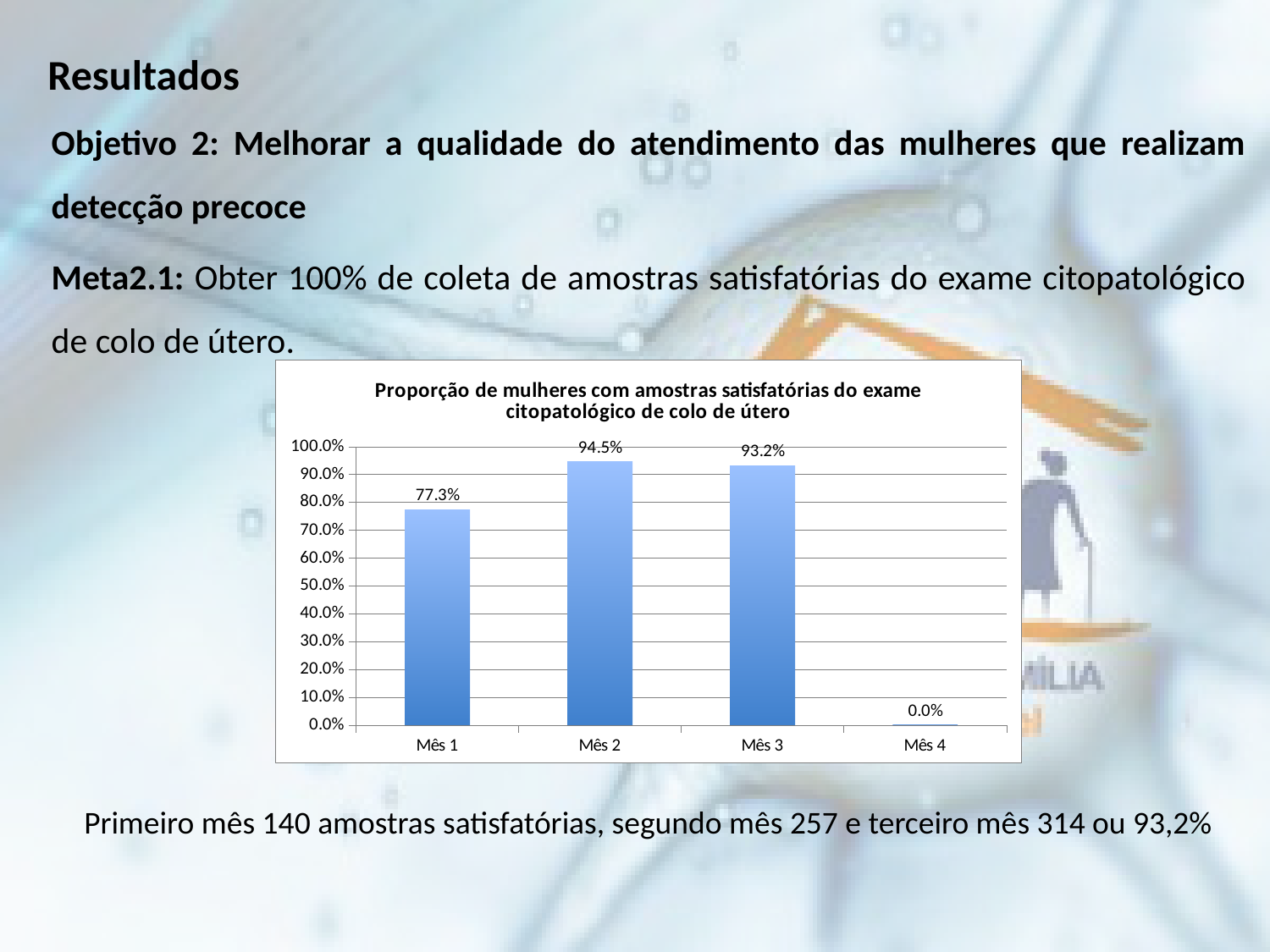
Which is larger, the value for Mês 1 or the value for Mês 3? Mês 3 How many months are shown on the x axis? 4 What is the value for Mês 1? 77.3% Is the value for Mês 1 greater or less than 80.0%? less What kind of chart is shown on the slide? bar chart What is the value for Mês 3? 93.2% Which month has the highest value? Mês 2 What is the value for Mês 4? 0.0% Which month has the lowest value? Mês 4 What is the title of the chart? Proporção de mulheres com amostras satisfatórias do exame citopatológico de colo de útero What is the value for Mês 2? 94.5% What is the difference between the values for Mês 2 and Mês 1? 17.2%